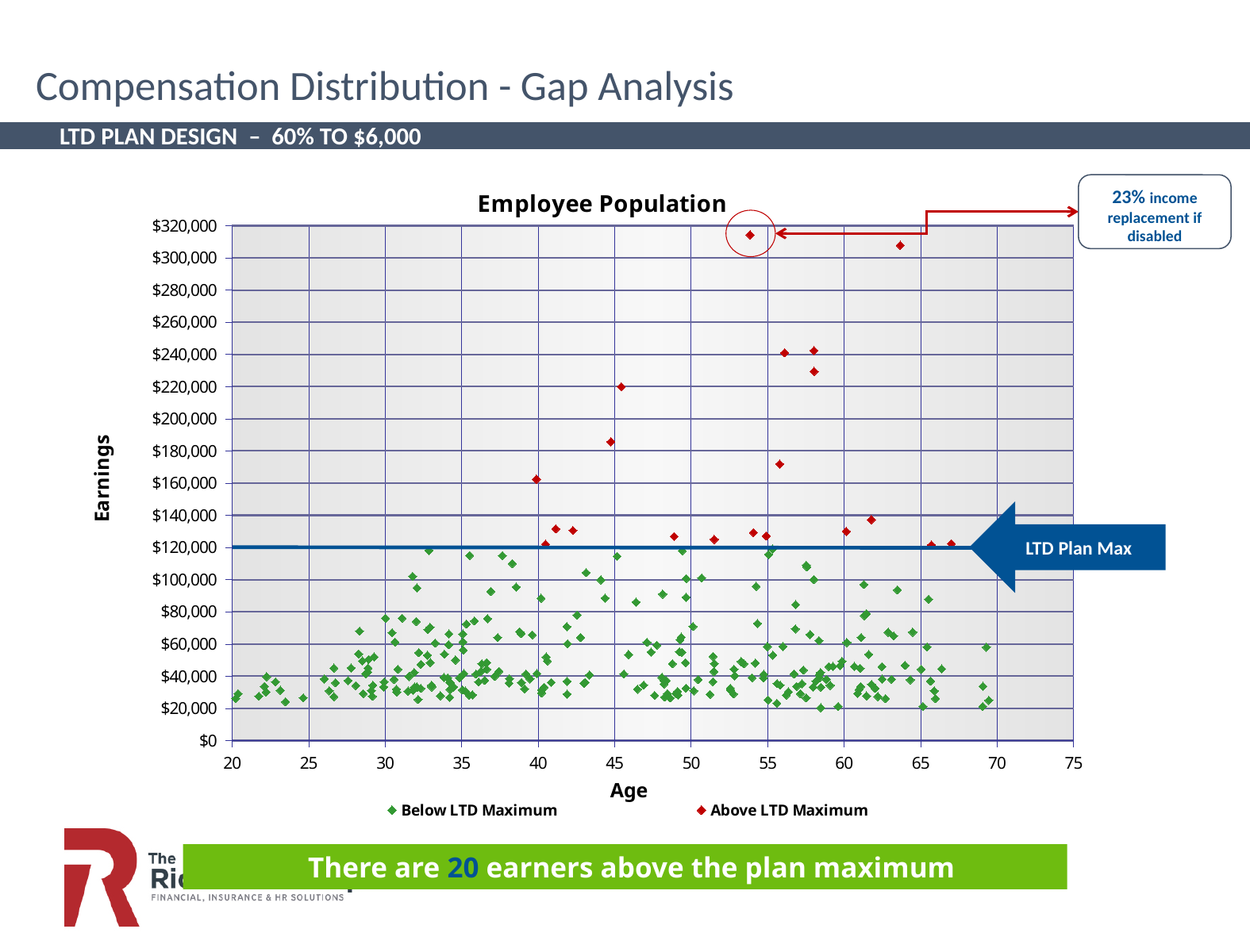
Which series has more plotted points, Below LTD Maximum or Above LTD Maximum? Below LTD Maximum What is the title of the chart on the slide? Employee Population What earnings level does the LTD Plan Max line sit at on the chart? $120,000 Is the age of the highest-earning employee greater or less than 50? greater How many series does the legend of the Employee Population chart list? 2 Is the earnings value of the lowest plotted point greater or less than $40,000? less What kind of chart is the Employee Population chart? Scatter chart What are the two legend entries on the Employee Population chart? Below LTD Maximum and Above LTD Maximum Is the earnings value of the highest plotted point greater or less than $300,000? greater According to the slide, how many earners are above the plan maximum? 20